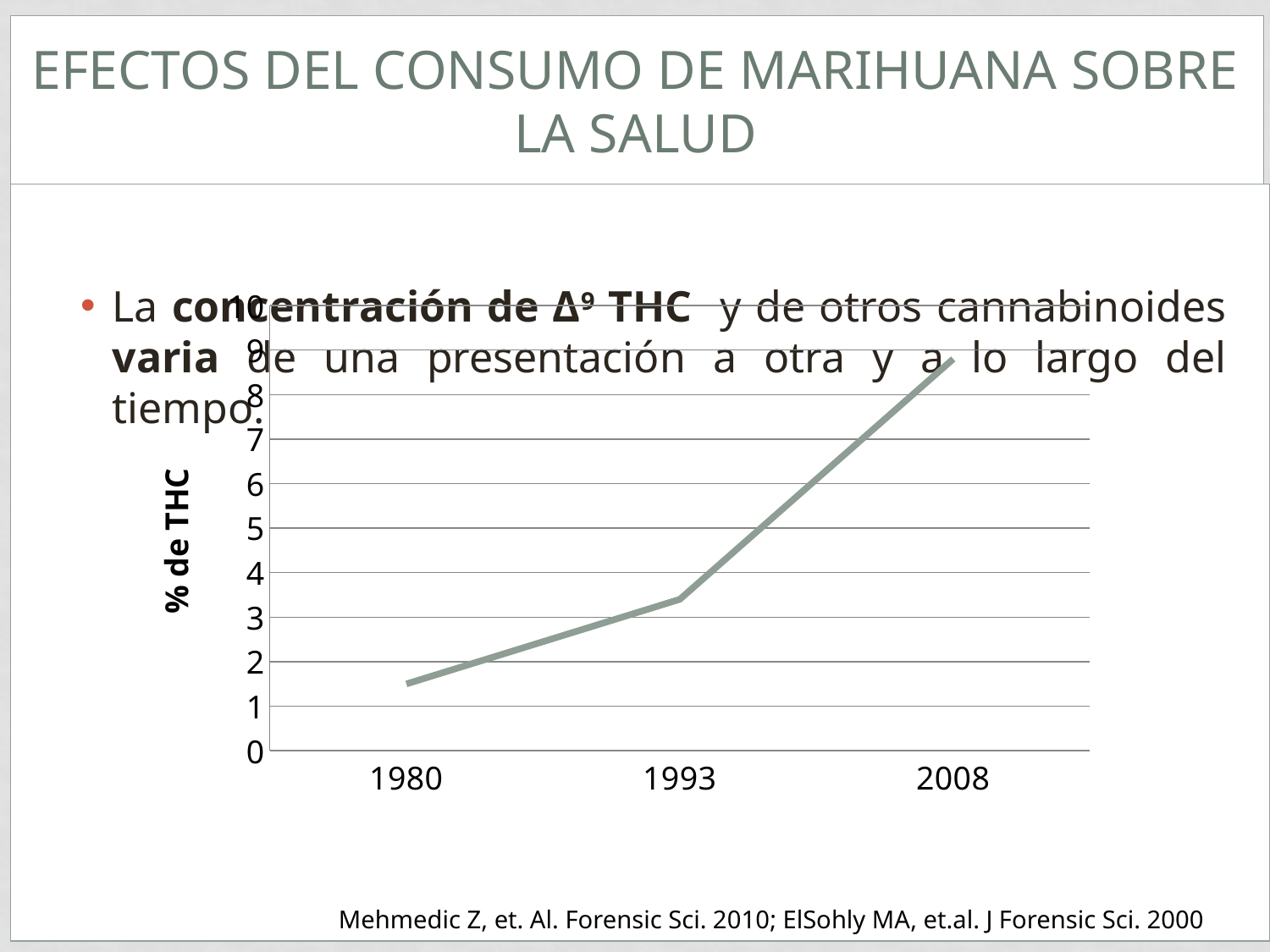
What is the title of the vertical axis of the chart? % de THC Is the value for 2008 greater or less than 8? greater Is the value for 1993 greater or less than 3? greater Which year has the highest % de THC in the chart? 2008 Does the % de THC rise or fall from 1980 to 2008 in the chart? rise What kind of chart is shown on the slide? line chart Is the value for 1980 greater or less than 2? less Which year has a higher % de THC, 1993 or 2008? 2008 How many years are plotted on the x axis of the chart? 3 Which year has a lower % de THC, 1980 or 1993? 1980 Which year has the lowest % de THC in the chart? 1980